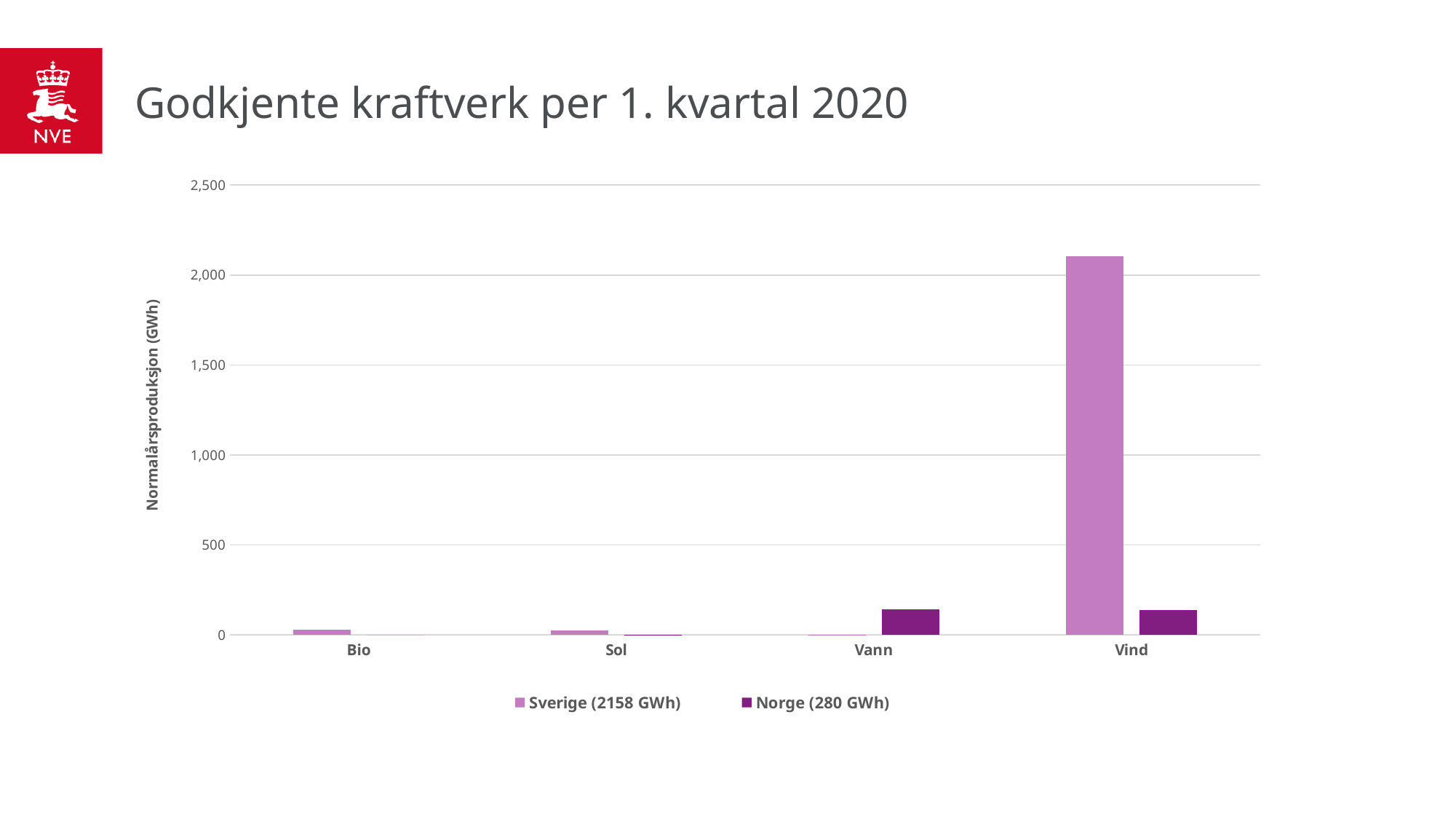
How many categories are shown on the x axis? 4 Is the value for Norge in the Vind category greater or less than 500? less How many series does the legend list? 2 In the Vind category, which series has the larger value, Sverige or Norge? Sverige What kind of chart is shown on the slide? bar chart In the Vann category, which series has the larger value, Sverige or Norge? Norge Is the value for Sverige in the Bio category greater or less than 500? less What total is given for Sverige in the legend? 2158 GWh What is the title of the slide? Godkjente kraftverk per 1. kvartal 2020 Is the value for Sverige in the Vind category greater or less than 2,000? greater Which category has the highest value for Sverige? Vind